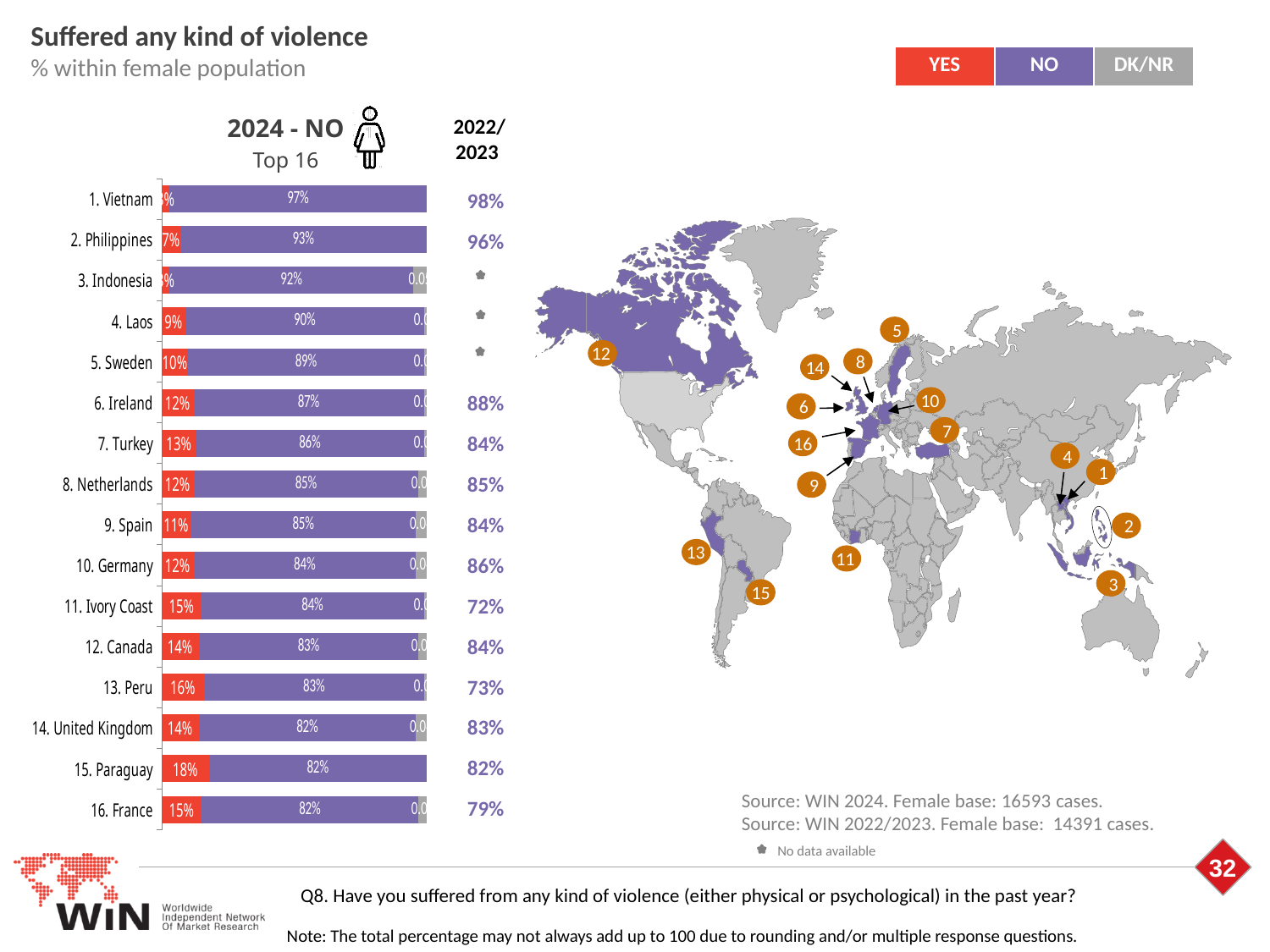
Which has a larger NO percentage in 2024, Turkey or Germany? Turkey What type of chart is used to show the Top 16 countries? Bar chart What is the YES percentage shown for Paraguay? 18% What is the 2022/2023 value shown for Ivory Coast? 72% How many response categories does the legend list? 3 What is the difference in percentage points between the NO value for the Philippines and the NO value for France? 11 percentage points Which country has the highest NO percentage in 2024? Vietnam Which country in the Top 16 has the highest YES percentage? Paraguay What percentage of the female population in Vietnam answered NO in 2024? 97% How many countries are listed in the bar chart? 16 By how many percentage points did Peru's NO value change from 2022/2023 to 2024? 10 percentage points Which colour represents the NO response in the legend? Purple